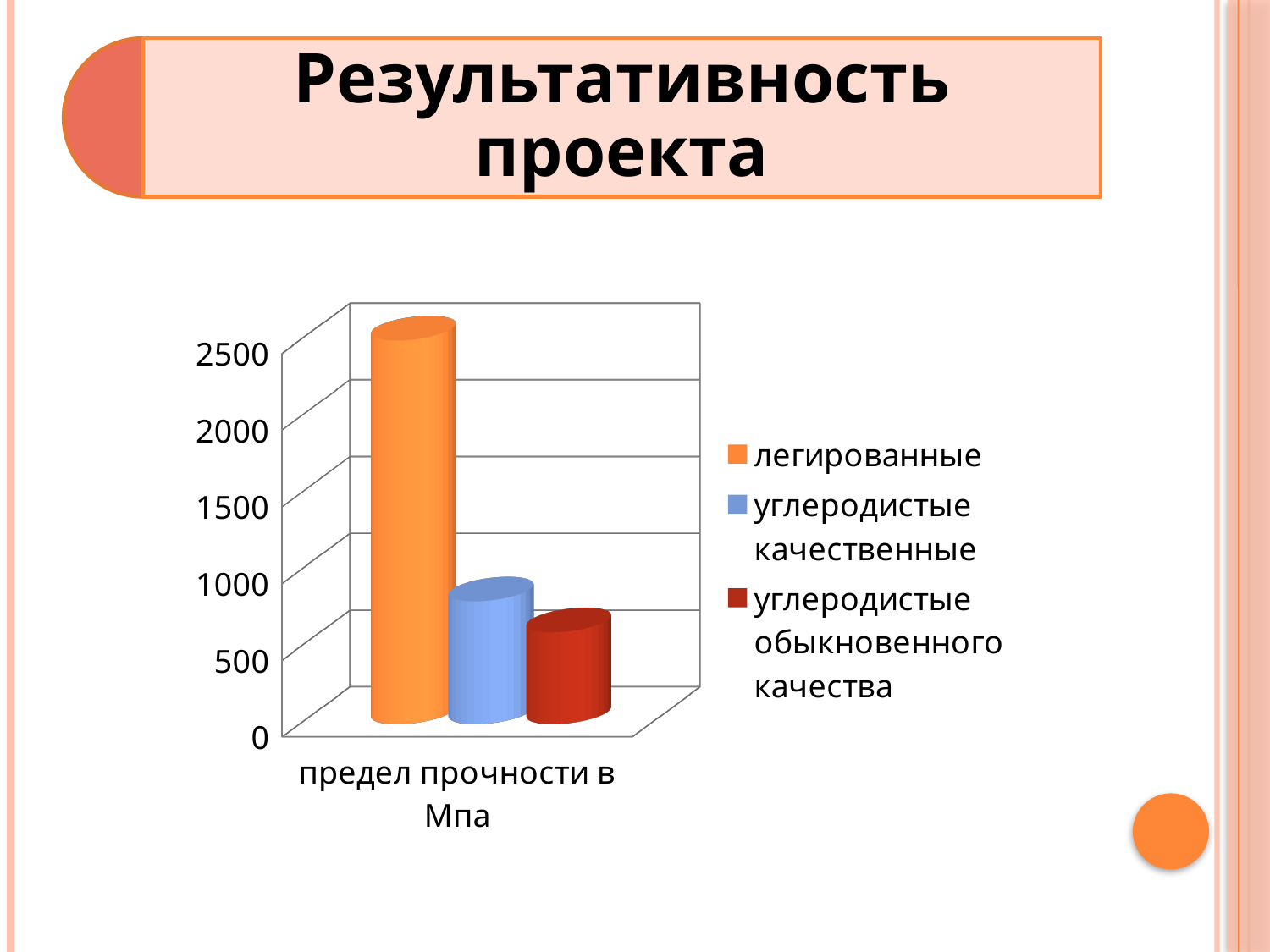
Which series has the lowest value for предел прочности в Мпа? углеродистые обыкновенного качества What kind of chart is shown on the slide? bar chart How many series does the legend list? 3 Which is larger: the value for легированные or the value for углеродистые качественные? легированные Is the value for углеродистые обыкновенного качества greater or less than 1000? less Is the value for углеродистые качественные greater or less than 1500? less What colour is the bar for легированные? orange How many categories are shown on the x axis? 1 What is the label of the category on the x axis? предел прочности в Мпа Which series has the highest value for предел прочности в Мпа? легированные Is the value for легированные greater or less than 2000? greater Which is larger: the value for углеродистые качественные or the value for углеродистые обыкновенного качества? углеродистые качественные